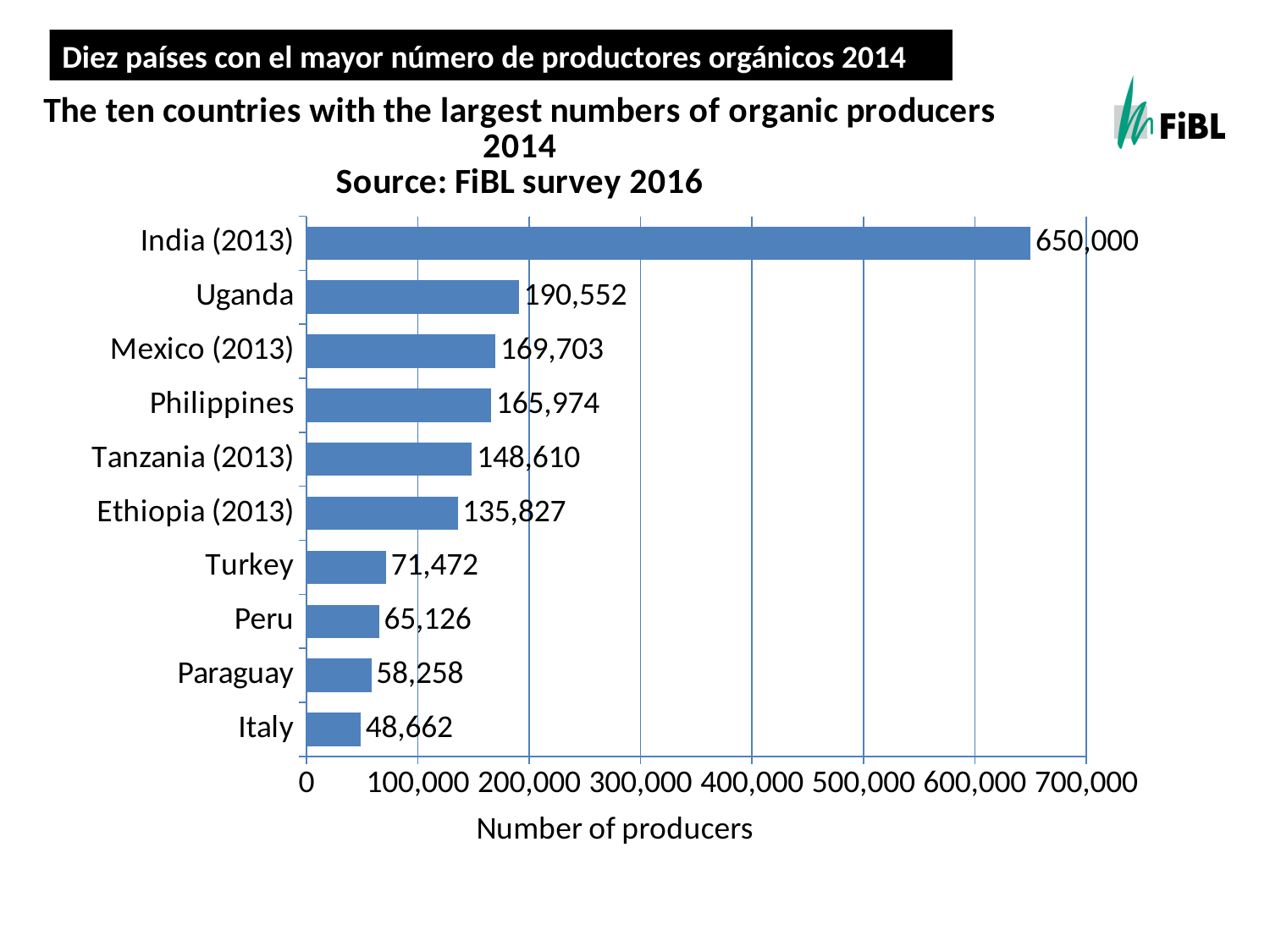
Which country has the smallest number of organic producers? Italy What is the number of organic producers for Italy? 48,662 What is the difference in the number of producers between Uganda and Mexico (2013)? 20,849 Is the value for Philippines greater or less than 200,000? less What is the label of the horizontal axis? Number of producers Which has more organic producers, Tanzania (2013) or Ethiopia (2013)? Tanzania (2013) How many countries are shown in the chart? 10 What kind of chart is shown on the slide? bar chart What is the number of organic producers for Uganda? 190,552 What is the difference in the number of producers between Peru and Paraguay? 6,868 What is the number of organic producers for Turkey? 71,472 Which country has the largest number of organic producers? India (2013)